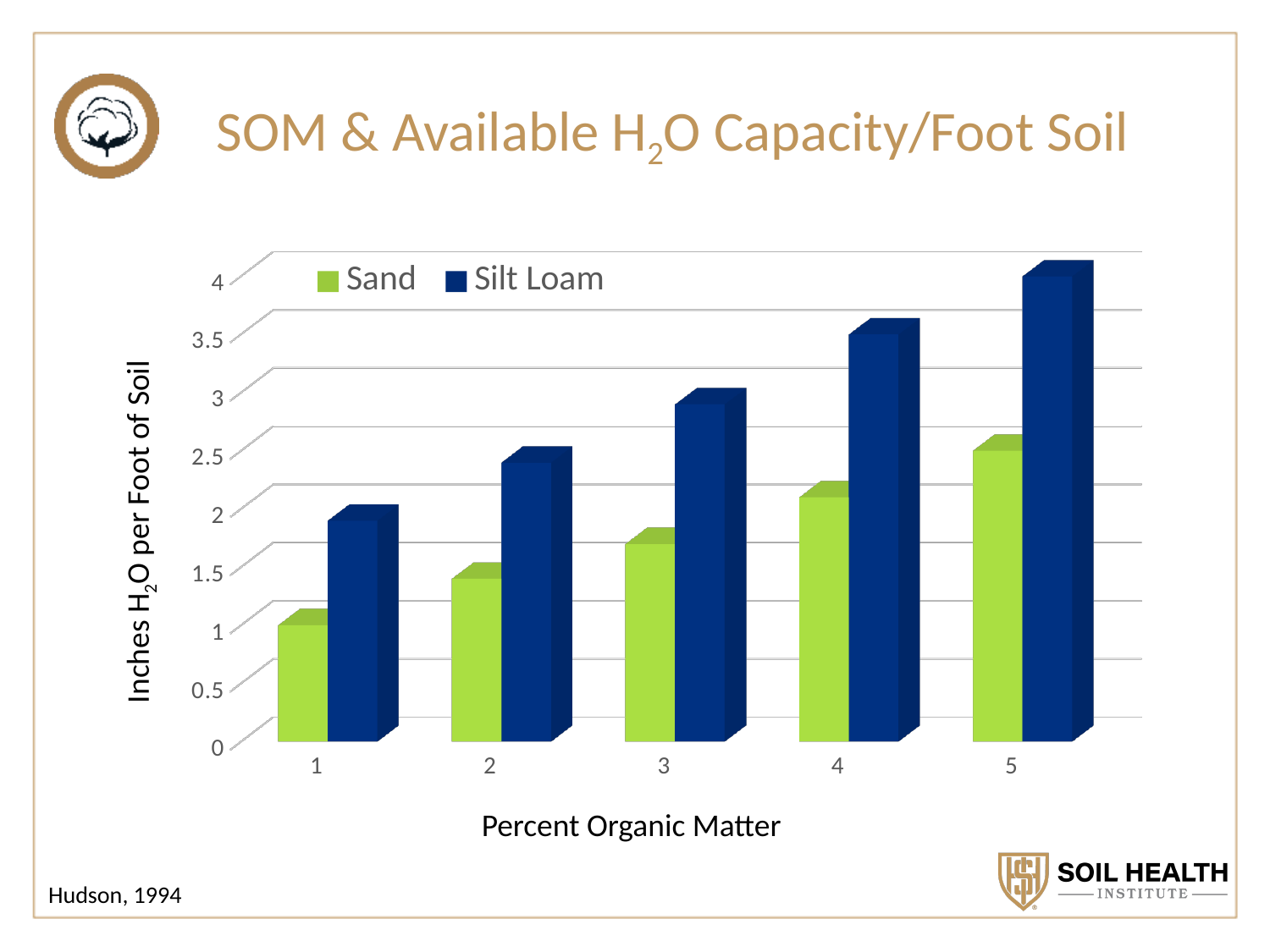
Is the Sand value at 3 percent organic matter greater or less than 2? less How many series does the legend list? 2 Is the Silt Loam value at 5 percent organic matter greater or less than 3.5? greater Which series has the highest value at 5 percent organic matter? Silt Loam Do the Silt Loam values rise or fall as percent organic matter increases from 1 to 5? rise Which series has the lowest value at 1 percent organic matter? Sand Is the Silt Loam value at 1 percent organic matter greater or less than 1.5? greater What kind of chart is shown on the slide? Bar chart What is the label of the y axis? Inches H2O per Foot of Soil How many percent organic matter categories are shown on the x axis? 5 Which is larger: the Sand value at 5 percent organic matter or the Silt Loam value at 1 percent organic matter? Sand at 5 percent organic matter